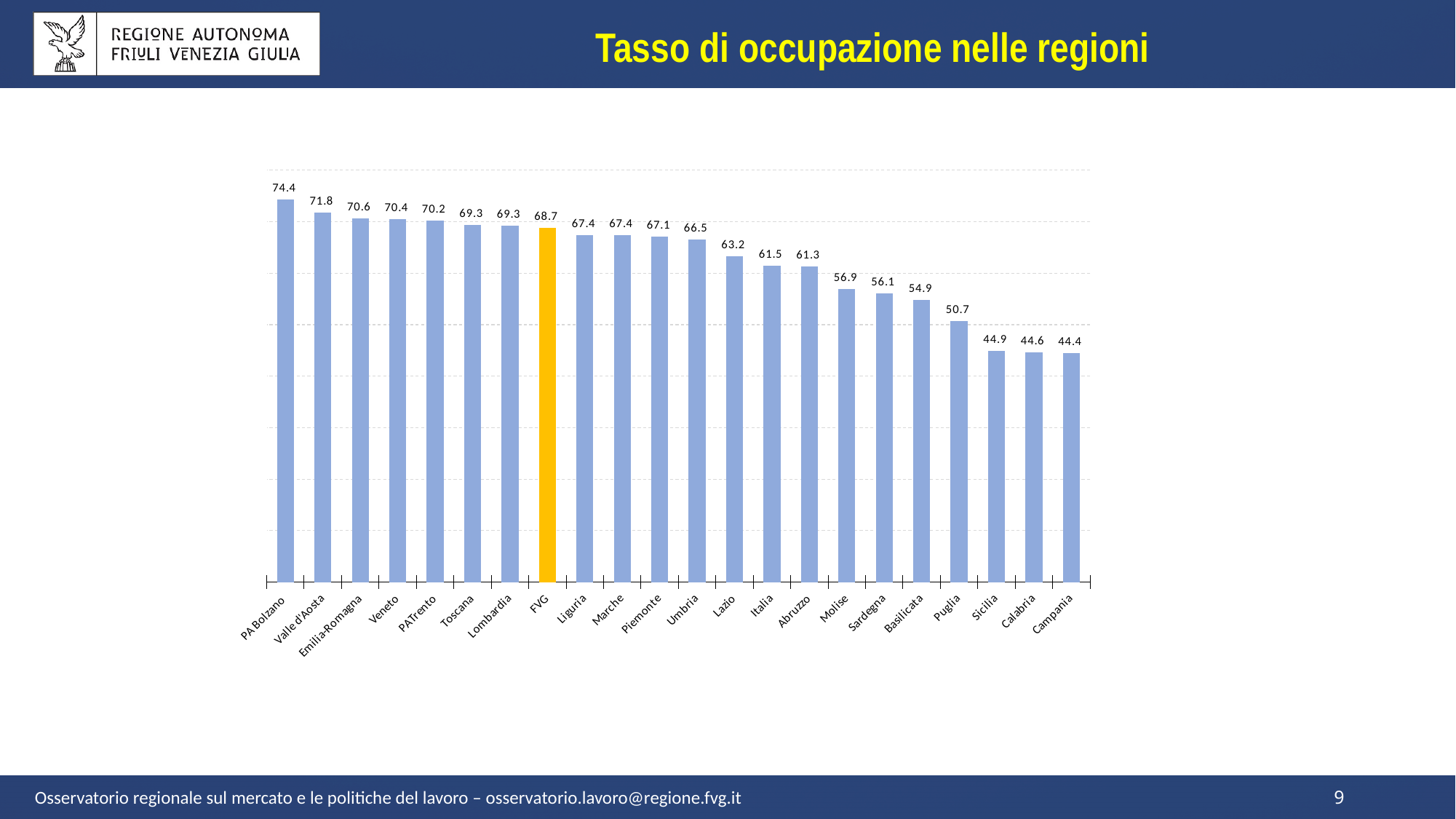
What is the difference between the values for PA Bolzano and Campania? 30.0 Which region has the lowest value? Campania Which region has the highest value? PA Bolzano Which has a larger value, Veneto or Puglia? Veneto What is the value for Lazio? 63.2 What is the value for Italia? 61.5 How many regions are shown on the x axis? 22 What is the difference between the values for FVG and Italia? 7.2 What kind of chart is shown on the slide? Bar chart What is the value for FVG? 68.7 Which has a larger value, Molise or Umbria? Umbria Which bar is highlighted in a different colour (orange) from the others? FVG